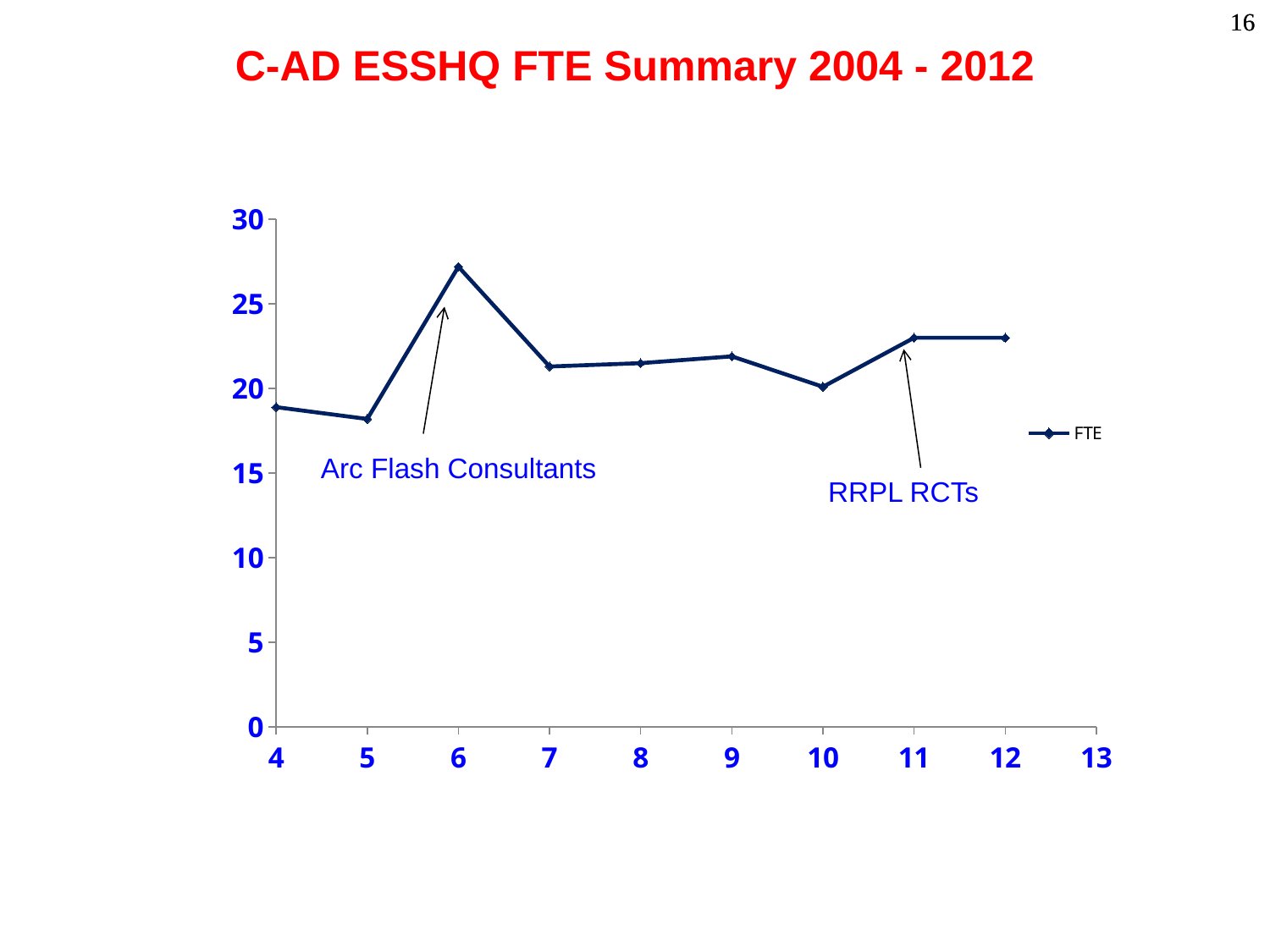
Which has the larger FTE value, x = 6 or x = 10? 6 Is the FTE value at x = 5 greater or less than 20? less Is the FTE value at x = 6 greater or less than 25? greater Is the FTE value at x = 11 greater or less than 20? greater How many data points are plotted on the FTE line? 9 How many series does the legend list? 1 What is the name of the series shown in the legend? FTE At which x-axis value is the FTE line highest? 6 Does the FTE line rise or fall from x = 5 to x = 6? rise At which x-axis value is the FTE line lowest? 5 What kind of chart is shown on the slide? line chart What is the title of the chart on the slide? C-AD ESSHQ FTE Summary 2004 - 2012